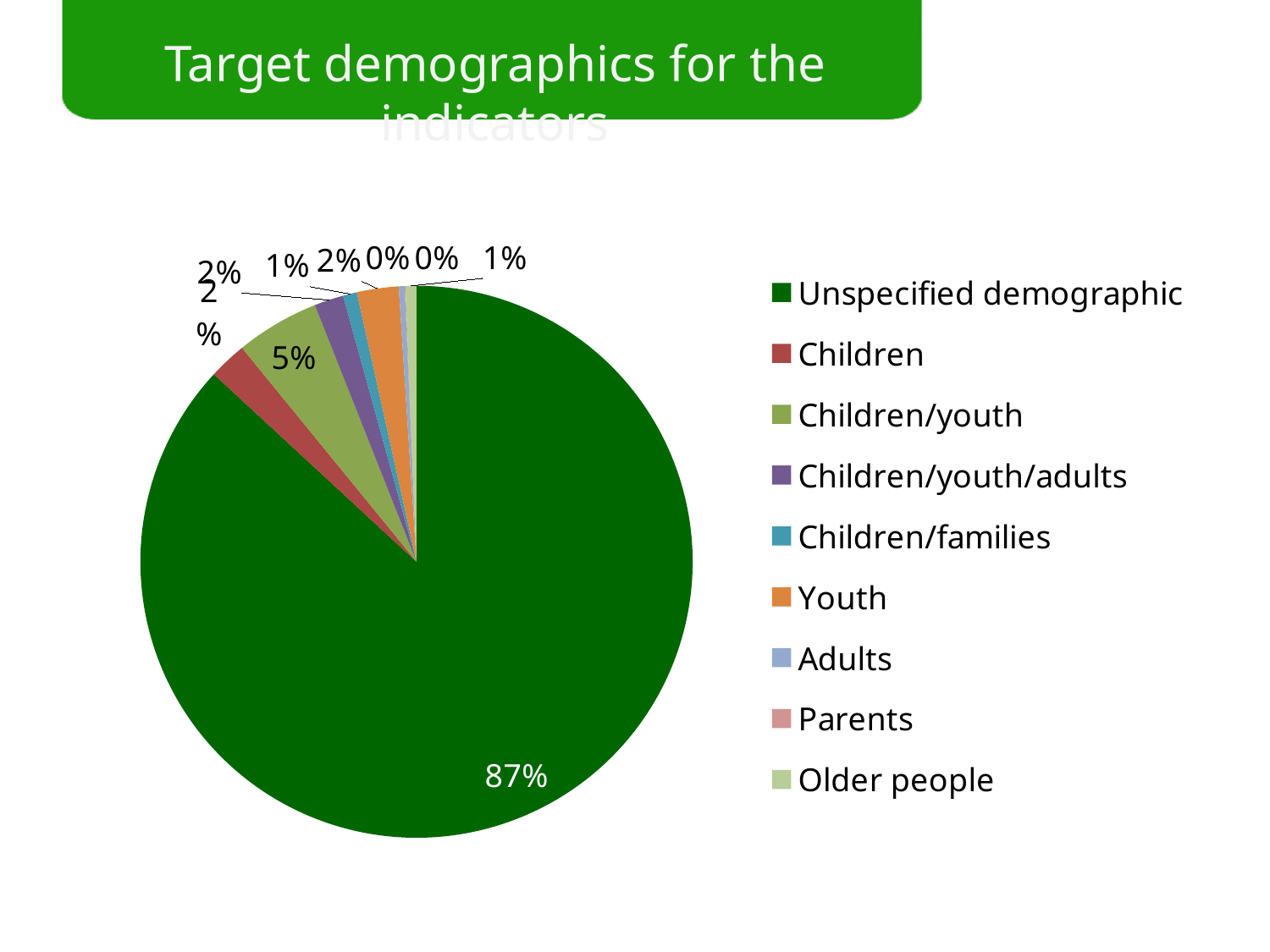
What percentage is shown for Children/youth? 5% What share of the pie does Unspecified demographic account for? 87% What is the title of the slide? Target demographics for the indicators Which is larger, the share for Children/youth or the share for Youth? Children/youth What percentage is shown for Adults? 0% What percentage is shown for Youth? 2% How many categories does the legend list? 9 What percentage is shown for Older people? 1% Which category has the largest slice of the pie? Unspecified demographic What type of chart is shown on the slide? Pie chart What is the difference in percentage points between Unspecified demographic and Children/youth? 82 What percentage is shown for Children/families? 1%